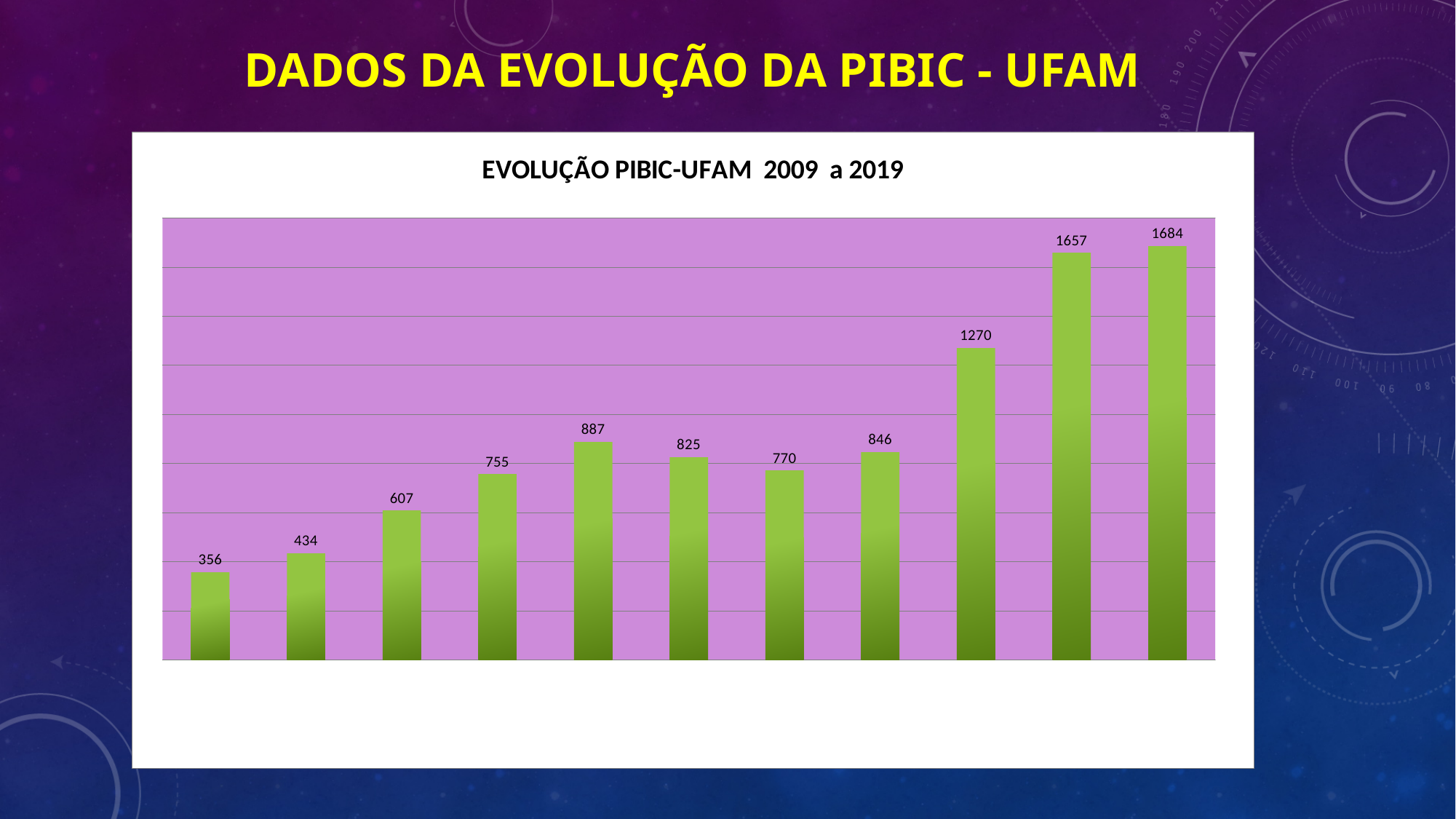
What is the value of the leftmost (first) bar? 356 What is the title of the chart? EVOLUÇÃO PIBIC-UFAM 2009 a 2019 What is the value of the third bar from the left? 607 Overall, do the values rise or fall from left to right across the chart? rise How many bars are plotted in the chart? 11 What is the difference between the last two bars, 1684 and 1657? 27 What is the difference between the rightmost bar (1684) and the leftmost bar (356)? 1328 What is the value of the ninth bar from the left? 1270 What is the lowest value shown in the chart? 356 Which is larger, the fifth bar (887) or the eighth bar (846)? the fifth bar (887) What kind of chart is shown on the slide? bar chart What is the highest value shown in the chart? 1684